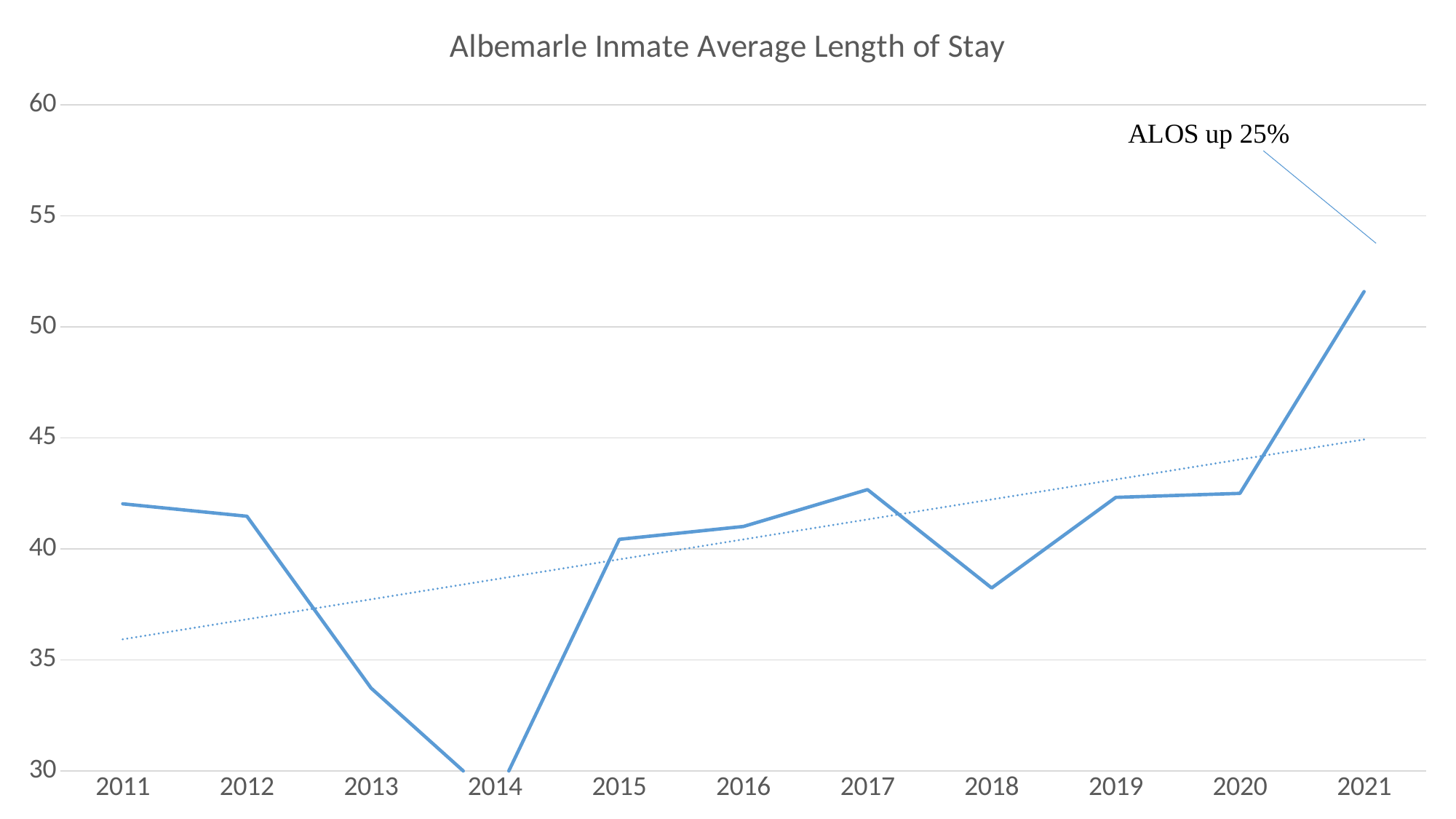
Is the value for 2013 greater or less than 35? less What does the annotation near the top right of the chart say? ALOS up 25% How many years are plotted along the x axis? 11 What is the title of the chart? Albemarle Inmate Average Length of Stay Which year has the lowest average length of stay? 2014 What kind of chart is shown on the slide? line chart Is the value for 2018 greater or less than 40? less Which year has the highest average length of stay? 2021 Is the value for 2021 greater or less than 50? greater Do the values rise or fall from 2018 to 2021? rise Which year has a higher value, 2011 or 2021? 2021 Which year has a higher value, 2017 or 2018? 2017